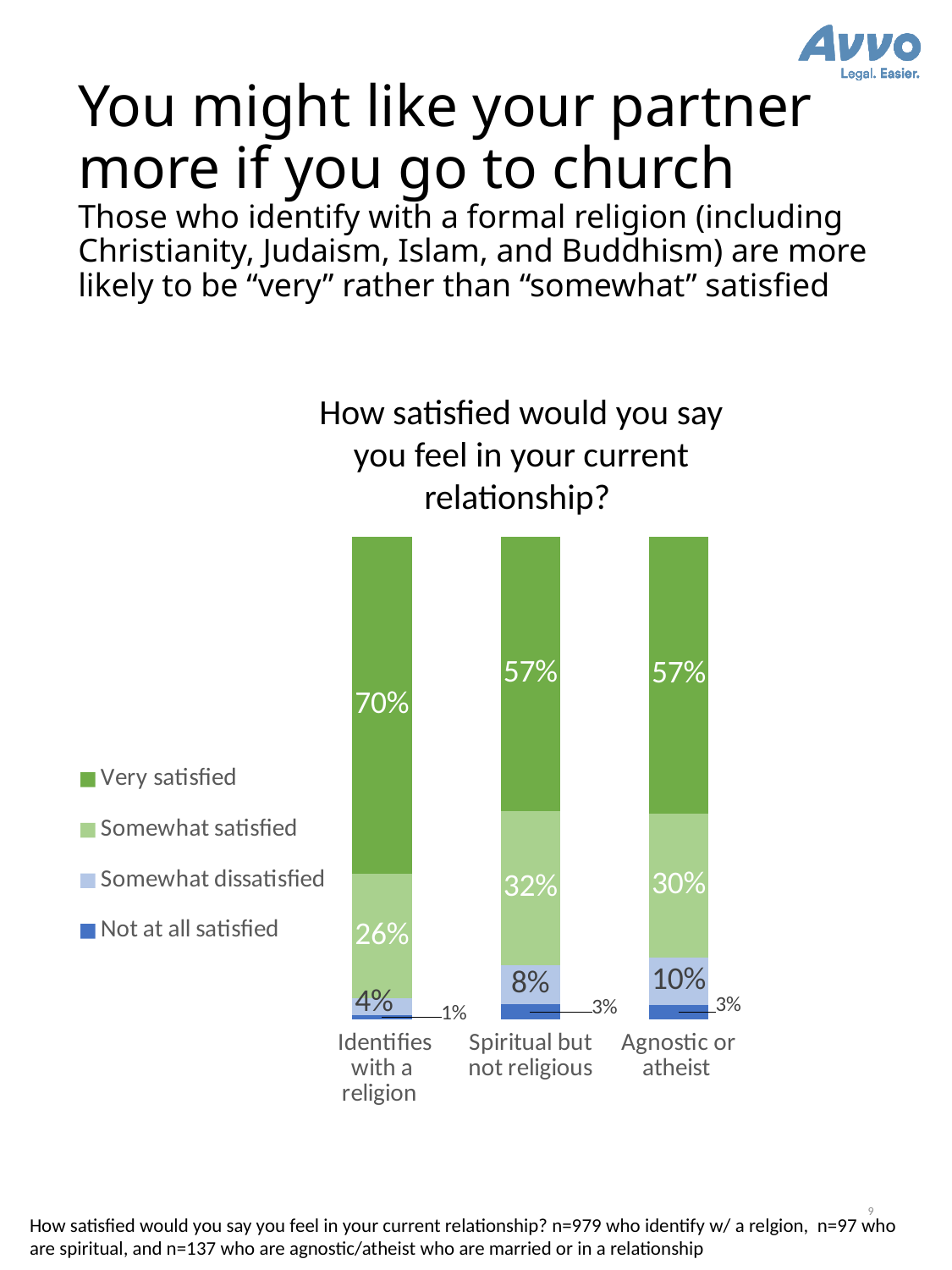
Which group has the lowest share of somewhat dissatisfied respondents? Identifies with a religion What kind of chart is shown on the slide? Stacked bar chart Which group has a larger somewhat satisfied share: spiritual but not religious or agnostic or atheist? Spiritual but not religious How many series does the legend list? 4 What percentage of those who identify with a religion are very satisfied in their current relationship? 70% What percentage of the spiritual but not religious group are somewhat satisfied? 32% Which group has the highest share of very satisfied respondents? Identifies with a religion What is the title of the chart? How satisfied would you say you feel in your current relationship? What is the difference in the very satisfied percentage between those who identify with a religion and those who are agnostic or atheist? 13% What percentage of those who identify with a religion are not at all satisfied? 1% How many groups are shown on the x axis of the chart? 3 What percentage of agnostic or atheist respondents are somewhat dissatisfied? 10%